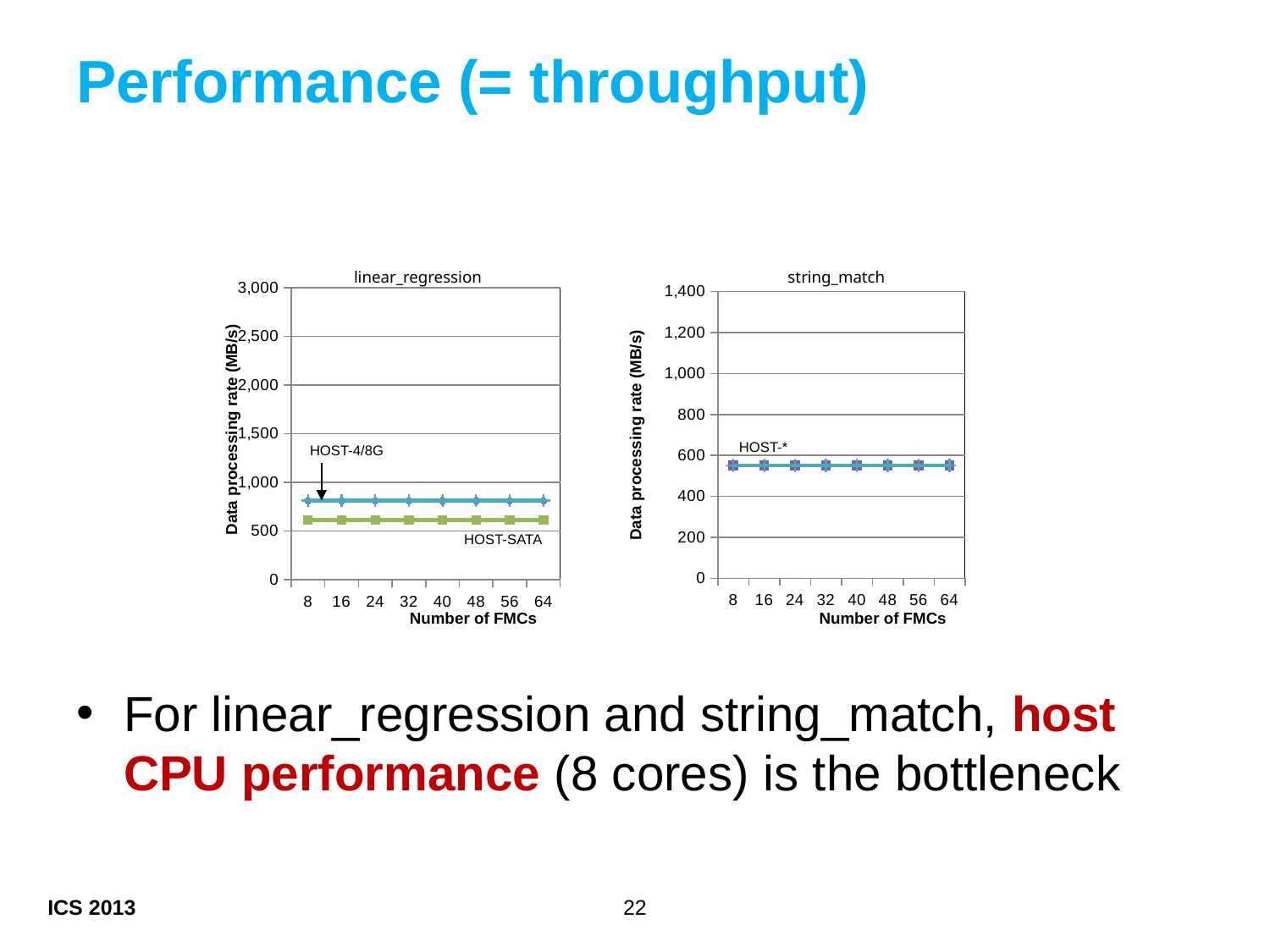
What is the maximum value shown on the y axis of the string_match chart? 1,400 What is the label of the x axis on the linear_regression chart? Number of FMCs In the string_match chart, is the value for HOST-* at 32 FMCs greater or less than 600? less In the string_match chart, how many data points are plotted along the x axis? 8 In the linear_regression chart, which series has the higher data processing rate, HOST-4/8G or HOST-SATA? HOST-4/8G In the linear_regression chart, is the value for HOST-SATA at 8 FMCs greater or less than 500? greater In the linear_regression chart, how many data points are plotted along the x axis for each series? 8 What kind of chart is the linear_regression chart? line chart What kind of chart is the string_match chart? line chart In the linear_regression chart, is the value for HOST-4/8G at 64 FMCs greater or less than 1,000? less In the string_match chart, does the data processing rate rise, fall, or stay flat as the number of FMCs increases? stays flat